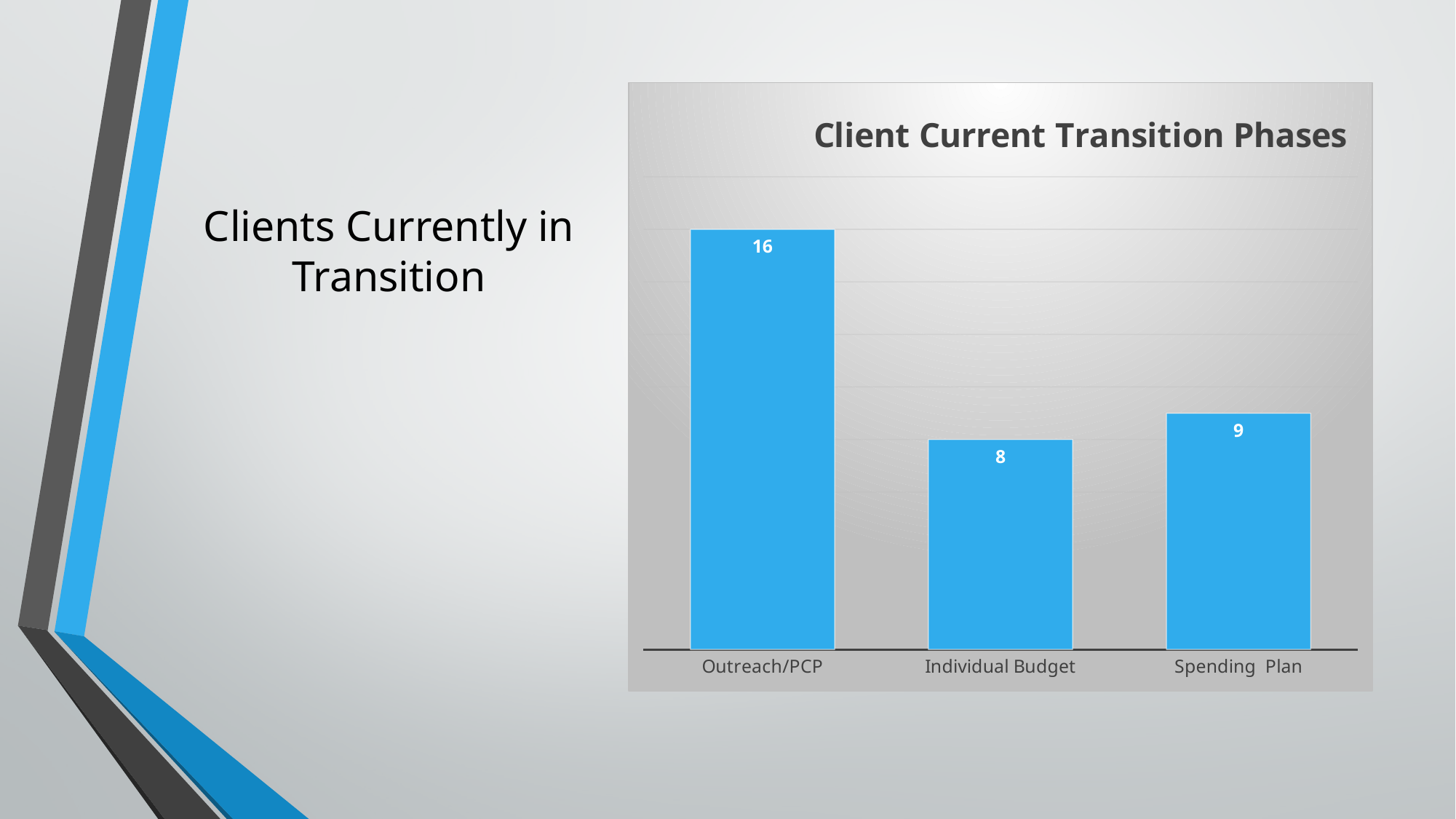
What is the title of the chart? Client Current Transition Phases What is the value for Outreach/PCP? 16 How many categories are shown on the chart? 3 Which is larger, the value for Outreach/PCP or the value for Spending Plan? Outreach/PCP Which transition phase has the lowest value? Individual Budget What is the value for Individual Budget? 8 What colour are the bars in the chart? Blue What is the value for Spending Plan? 9 What is the difference between the values for Outreach/PCP and Individual Budget? 8 Which transition phase has the highest value? Outreach/PCP What is the difference between the values for Spending Plan and Individual Budget? 1 What kind of chart is shown on the slide? Bar chart